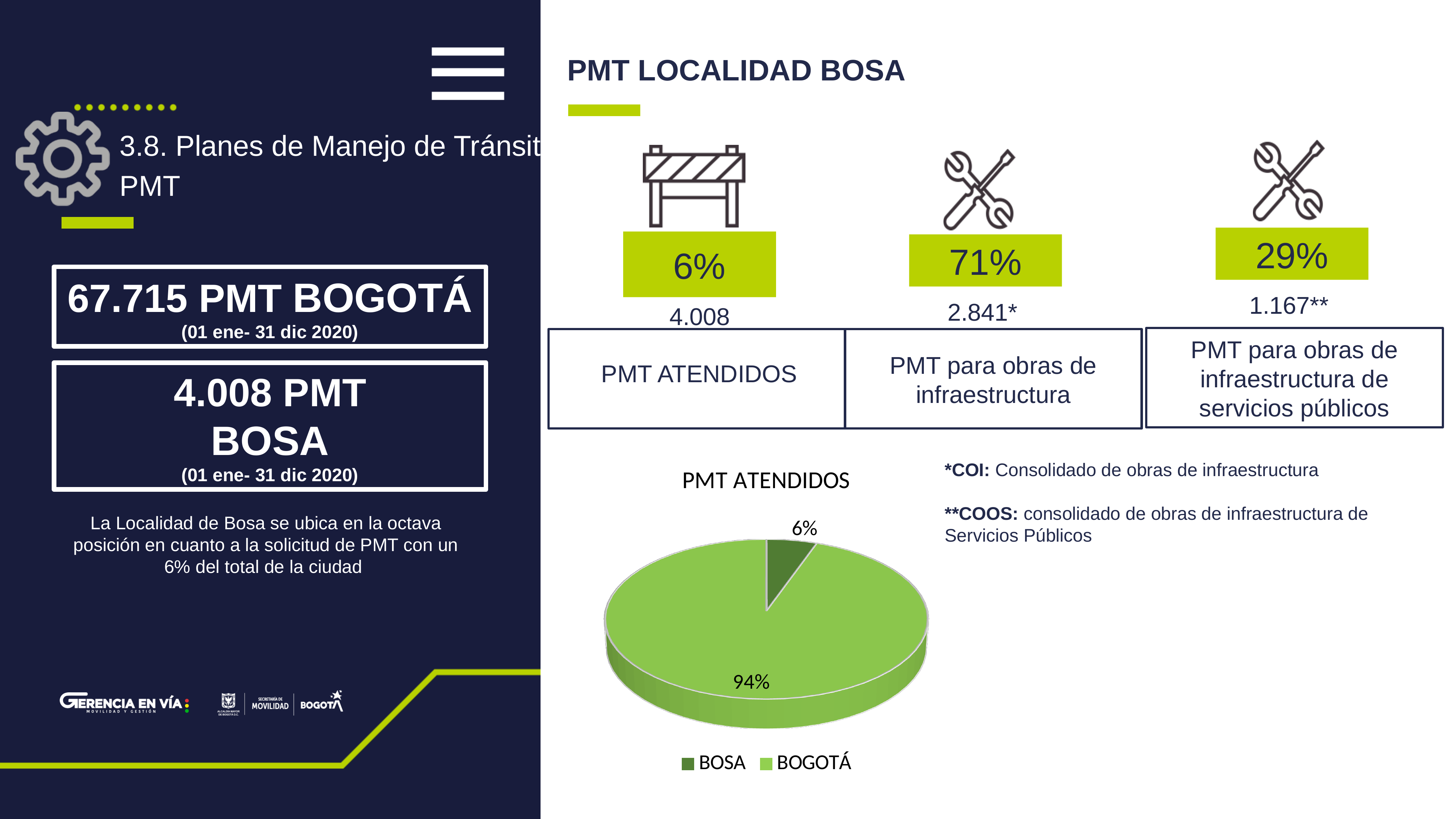
In the PMT ATENDIDOS pie chart, which legend entry is shown in dark green? BOSA How many slices does the PMT ATENDIDOS pie chart have? 2 In the PMT ATENDIDOS pie chart, what share does BOGOTÁ have? 94% What kind of chart is shown under the title PMT ATENDIDOS? pie chart In the PMT ATENDIDOS pie chart, what is the difference in percentage points between BOGOTÁ and BOSA? 88 What is the title of the pie chart? PMT ATENDIDOS In the PMT ATENDIDOS pie chart, which is larger, BOSA or BOGOTÁ? BOGOTÁ In the PMT ATENDIDOS pie chart, which slice is the largest? BOGOTÁ In the PMT ATENDIDOS pie chart, which slice is the smallest? BOSA In the PMT ATENDIDOS pie chart, what share does BOSA have? 6% How many entries does the legend of the PMT ATENDIDOS pie chart list? 2